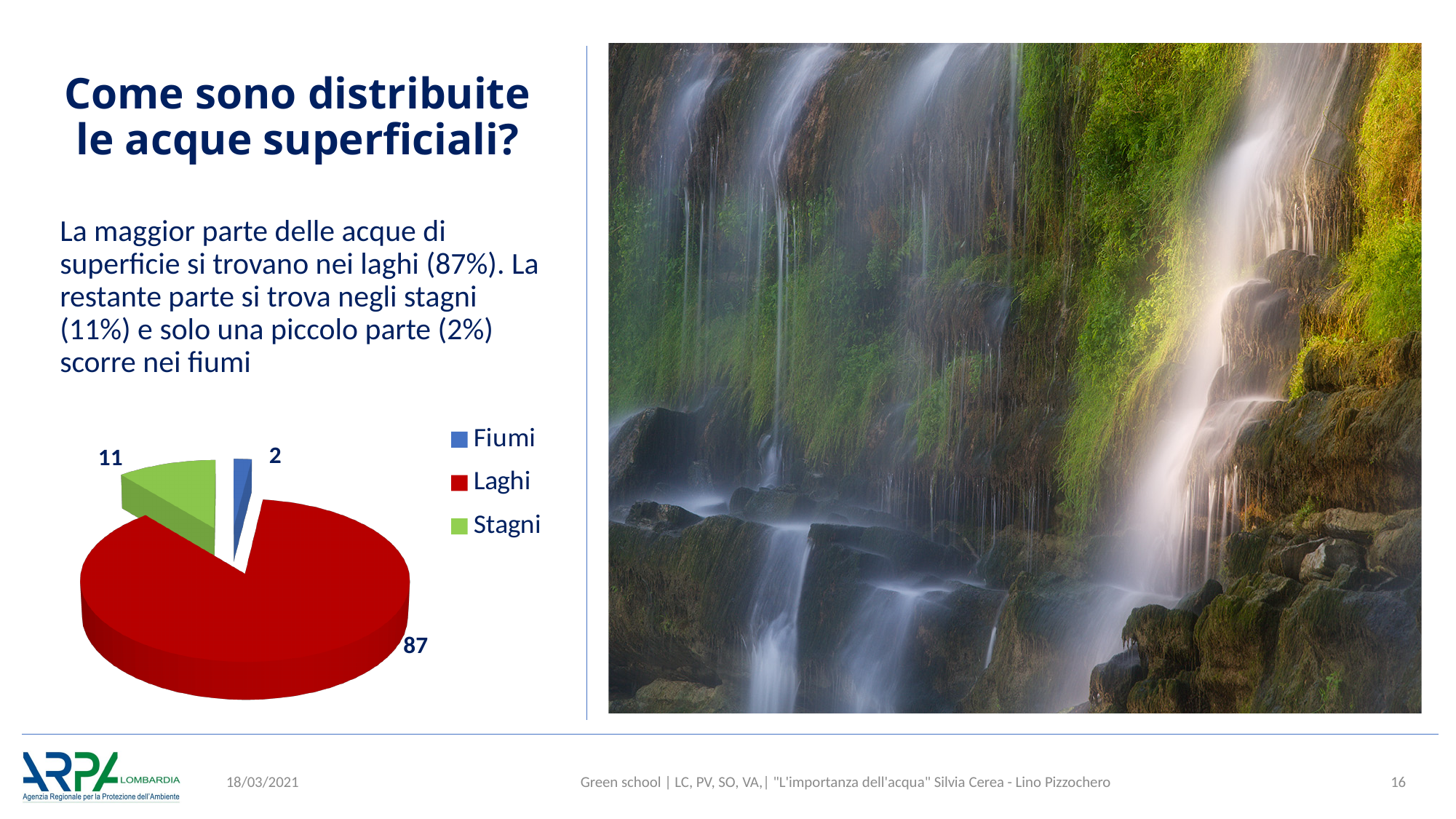
Which category has the smallest slice in the pie chart? Fiumi What is the difference between the values for Laghi and Stagni? 76 What kind of chart is shown on the slide? pie chart What is the value for Stagni in the pie chart? 11 What is the difference between the values for Stagni and Fiumi? 9 How many entries does the legend list? 3 What is the value for Laghi in the pie chart? 87 What colour is the Laghi slice in the pie chart? red Which is larger, the value for Stagni or the value for Fiumi? Stagni How many slices does the pie chart have? 3 What is the value for Fiumi in the pie chart? 2 Which category has the largest slice in the pie chart? Laghi